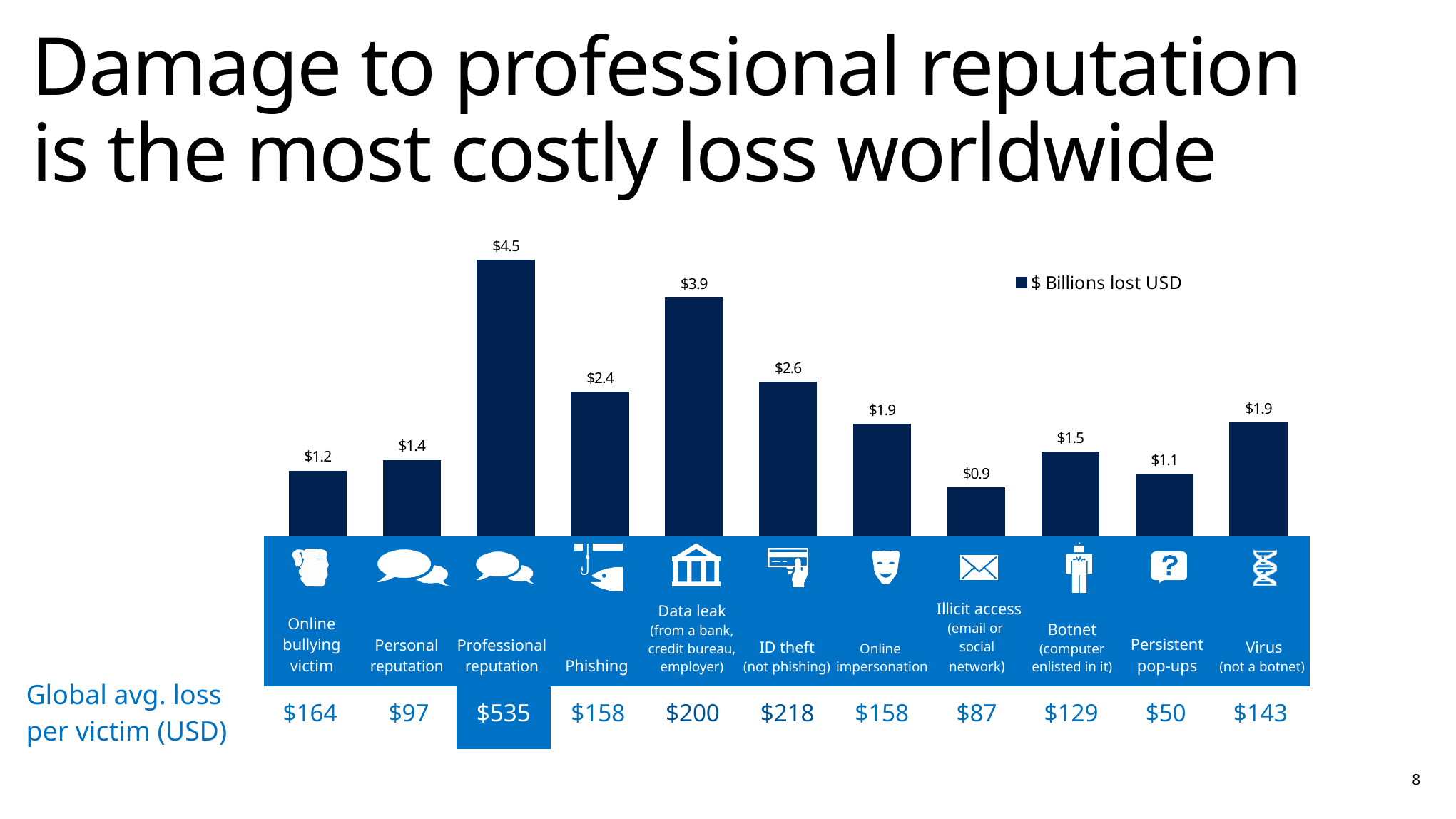
What is the value of $ Billions lost USD for Professional reputation? $4.5 What is the value of $ Billions lost USD for Data leak (from a bank, credit bureau, employer)? $3.9 Which has a larger $ Billions lost USD value, Phishing or ID theft (not phishing)? ID theft (not phishing) What is the value of $ Billions lost USD for Illicit access (email or social network)? $0.9 What is the legend entry for the series in the chart? $ Billions lost USD Which category has the lowest $ Billions lost USD? Illicit access (email or social network) What kind of chart is shown on the slide? Bar chart What is the $ Billions lost USD value for Virus (not a botnet)? $1.9 How many categories are shown in the bar chart? 11 How many series does the legend list? 1 Which category has the highest $ Billions lost USD? Professional reputation What is the difference in $ Billions lost USD between Professional reputation and Data leak? $0.6